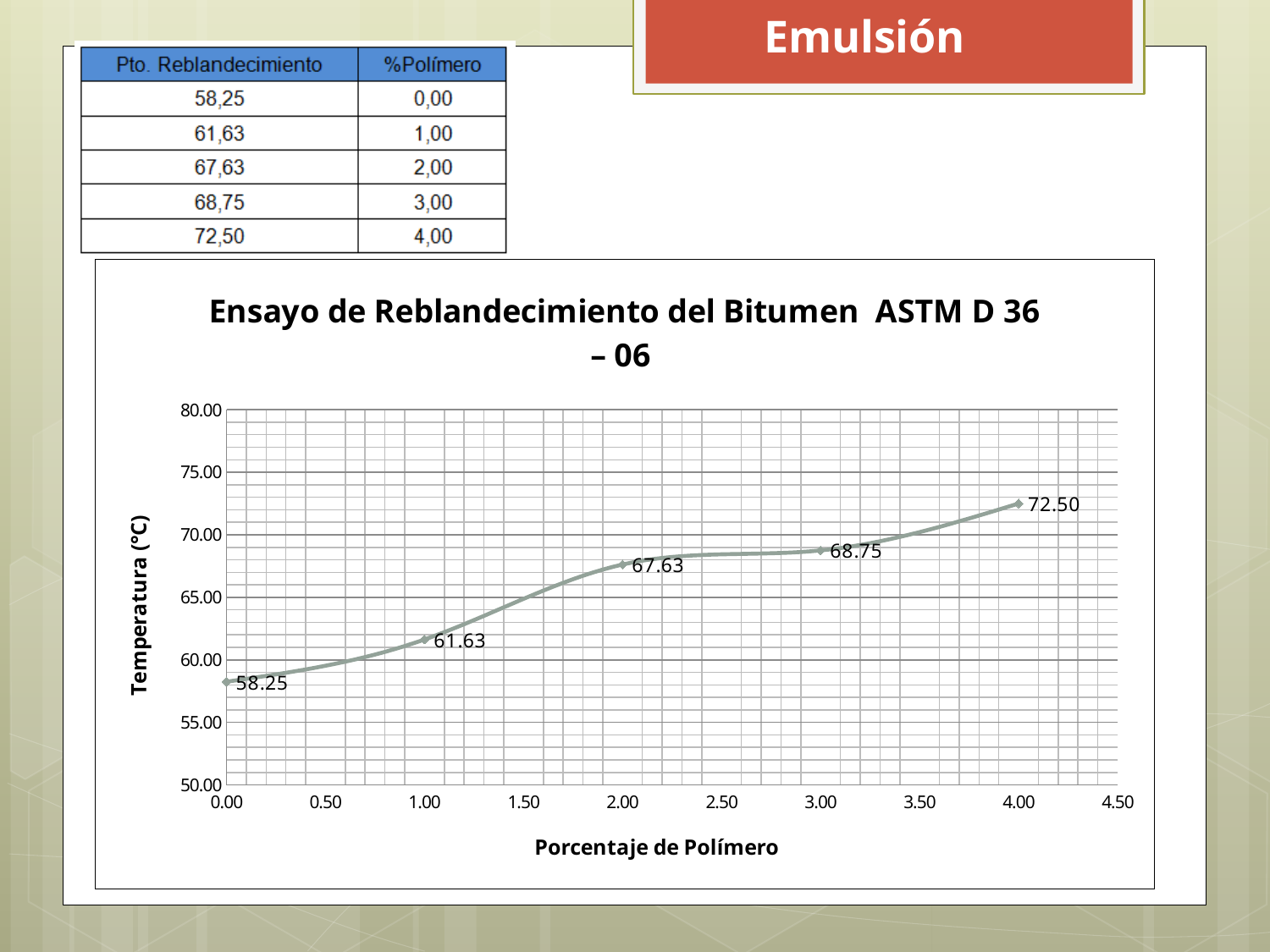
What is the difference between the temperature at 4.00% and at 0.00% polymer? 14.25 Does the temperature rise or fall as the polymer percentage increases? Rise What is the label of the y axis? Temperatura (°C) What kind of chart is shown? Line chart What is the temperature value at 3.00% polymer? 68.75 At which polymer percentage is the temperature highest? 4.00 At which polymer percentage is the temperature lowest? 0.00 What is the temperature value at 2.00% polymer? 67.63 How many data points are plotted on the chart? 5 What is the temperature value at 0.00% polymer? 58.25 Which is larger, the temperature at 1.00% polymer or at 2.00% polymer? 2.00% polymer What is the temperature value at 4.00% polymer? 72.50